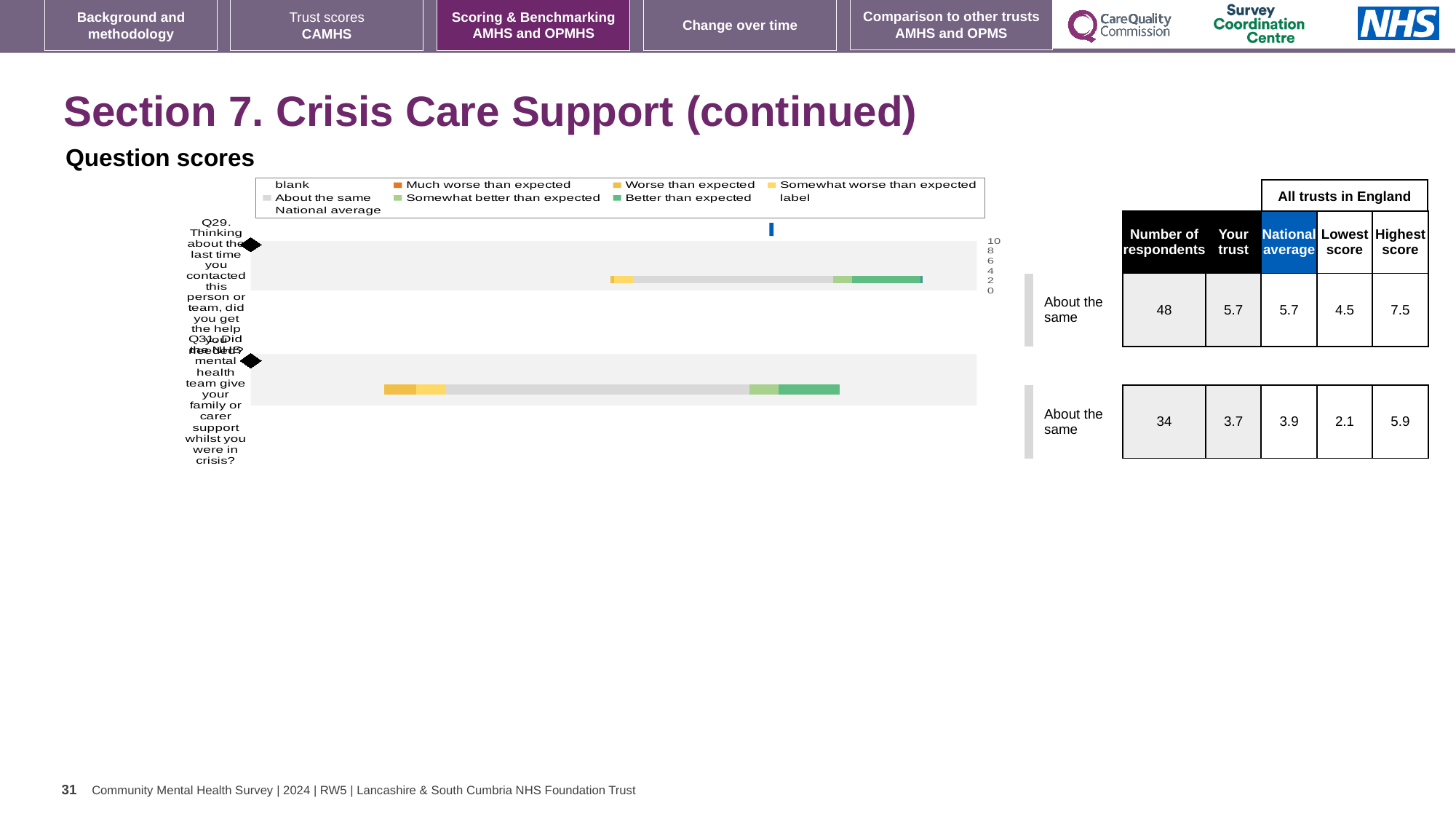
Which legend entry is shown in dark green? Better than expected In the table beside the chart, what is the "Your trust" score for Q29? 5.7 How many entries does the chart legend list? 9 In the table beside the chart, what is the highest score among all trusts in England for Q31? 5.9 In the table beside the chart, what is the "Your trust" score for Q31? 3.7 What is the heading above the chart? Question scores What kind of chart is shown under the heading "Question scores"? bar chart In the table beside the chart, what is the difference between the highest and lowest score for Q29? 3.0 In the table beside the chart, what is the national average for Q31? 3.9 How many questions (bars) are plotted in the chart? 2 In the table beside the chart, which question has the higher "Your trust" score, Q29 or Q31? Q29 In the table beside the chart, how many respondents answered Q29? 48